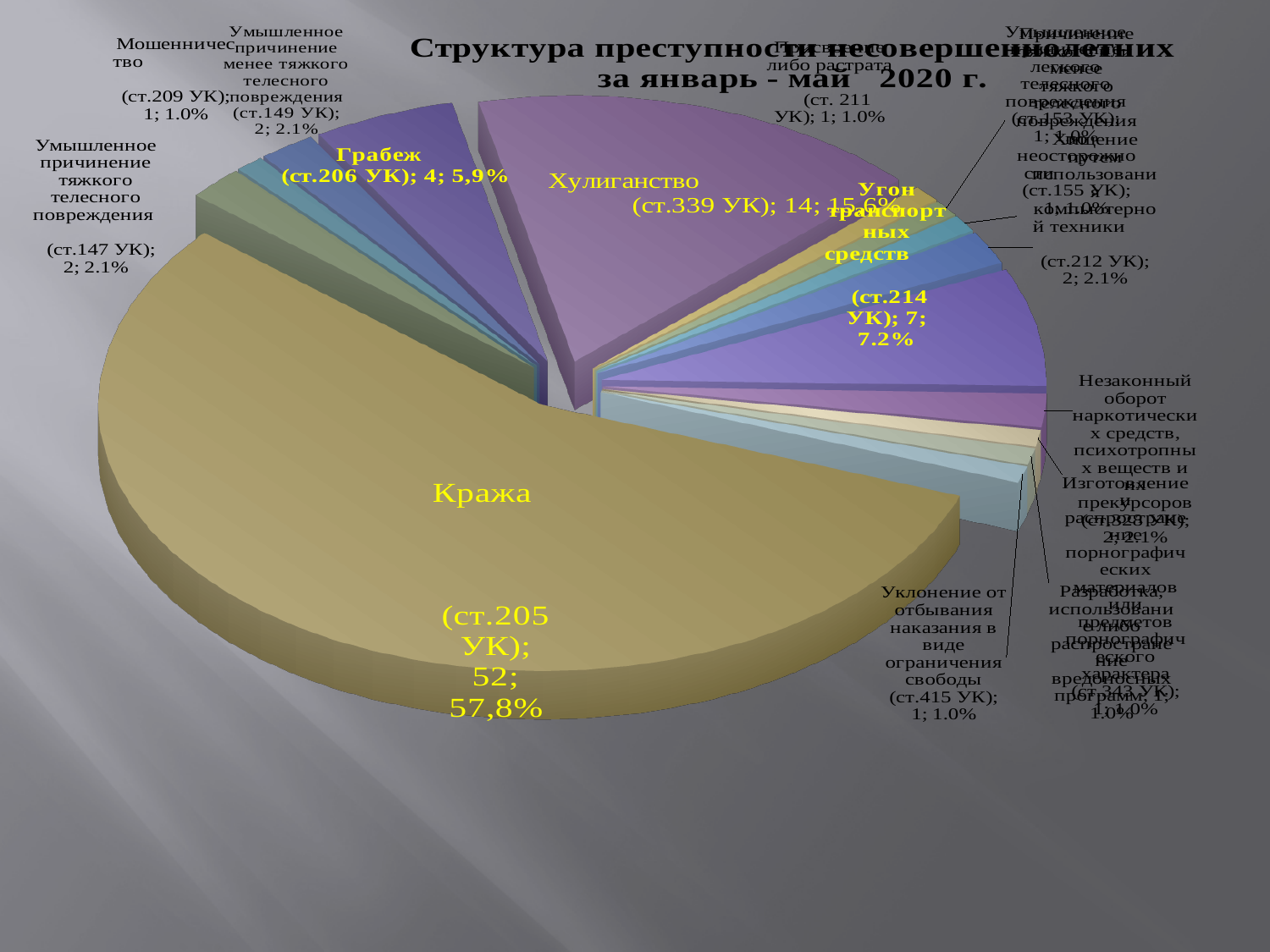
Which category has the largest slice of the pie? Кража (ст.205 УК) How many cases are shown for Хулиганство (ст.339 УК)? 14 What share of the pie does Грабеж (ст.206 УК) represent? 5,9% What is the title of the chart? Структура преступности несовершеннолетних за январь - май 2020 г. What share of the pie does Кража (ст.205 УК) represent? 57,8% What share of the pie does Хулиганство (ст.339 УК) represent? 15,6% How many cases are shown for Мошенничество (ст.209 УК)? 1 What is the difference in the number of cases between Кража (ст.205 УК) and Хулиганство (ст.339 УК)? 38 How many cases are shown for Угон транспортных средств (ст.214 УК)? 7 Which has more cases, Угон транспортных средств (ст.214 УК) or Грабеж (ст.206 УК)? Угон транспортных средств (ст.214 УК) How many cases are shown for Кража (ст.205 УК)? 52 What kind of chart is shown on the slide? pie chart